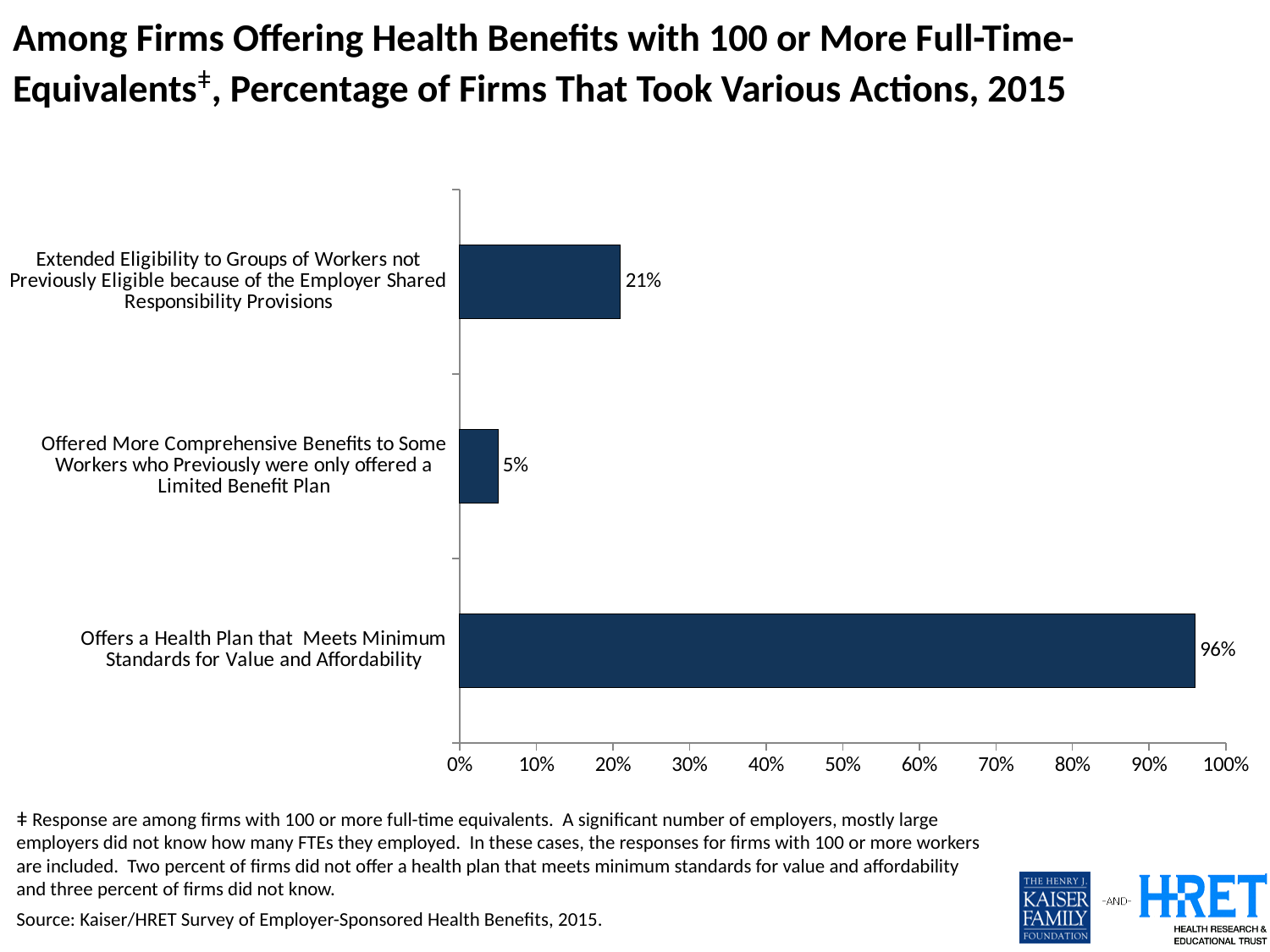
Which action has the lowest percentage of firms? Offered More Comprehensive Benefits to Some Workers who Previously were only offered a Limited Benefit Plan What is the difference in percentage points between firms that offer a health plan meeting minimum standards and firms that extended eligibility to groups of workers not previously eligible? 75 percentage points What type of chart is shown on the slide? Bar chart What percentage of firms extended eligibility to groups of workers not previously eligible because of the Employer Shared Responsibility Provisions? 21% What is the difference in percentage points between firms that extended eligibility to groups of workers not previously eligible and firms that offered more comprehensive benefits to some workers? 16 percentage points Which is larger: the percentage of firms that extended eligibility to groups of workers not previously eligible, or the percentage that offered more comprehensive benefits to some workers? Extended Eligibility to Groups of Workers not Previously Eligible What percentage of firms offered more comprehensive benefits to some workers who previously were only offered a limited benefit plan? 5% Is the value for firms that offer a health plan meeting minimum standards for value and affordability greater or less than 90%? greater How many actions (categories) are shown in the chart? 3 Which action has the highest percentage of firms? Offers a Health Plan that Meets Minimum Standards for Value and Affordability What is the maximum value shown on the horizontal axis of the chart? 100% What percentage of firms offer a health plan that meets minimum standards for value and affordability? 96%